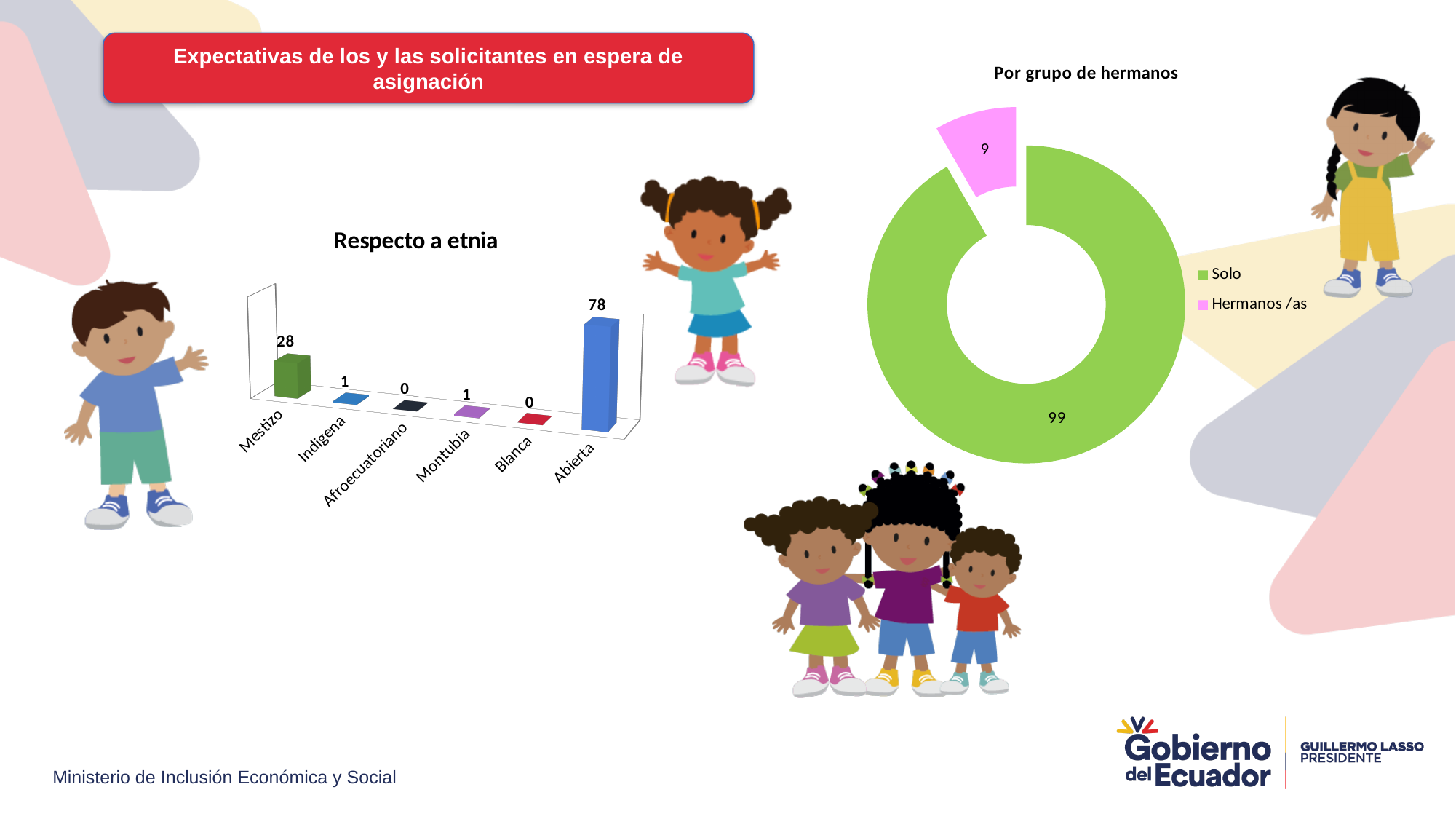
In the 'Respecto a etnia' chart, what is the value for Mestizo? 28 How many categories are shown in the 'Respecto a etnia' chart? 6 In the 'Respecto a etnia' chart, what is the value for Abierta? 78 What kind of chart is 'Respecto a etnia'? Bar chart In the 'Respecto a etnia' chart, which is larger, the value for Indigena or the value for Blanca? Indigena In the 'Por grupo de hermanos' chart, what is the value for Hermanos /as? 9 How many entries does the legend of the 'Por grupo de hermanos' chart list? 2 In the 'Por grupo de hermanos' chart, what is the difference between the values for Solo and Hermanos /as? 90 In the 'Respecto a etnia' chart, which category has the highest value? Abierta In the 'Respecto a etnia' chart, what is the value for Montubia? 1 In the 'Respecto a etnia' chart, what is the difference between the values for Abierta and Mestizo? 50 In the 'Por grupo de hermanos' chart, what is the value for Solo? 99